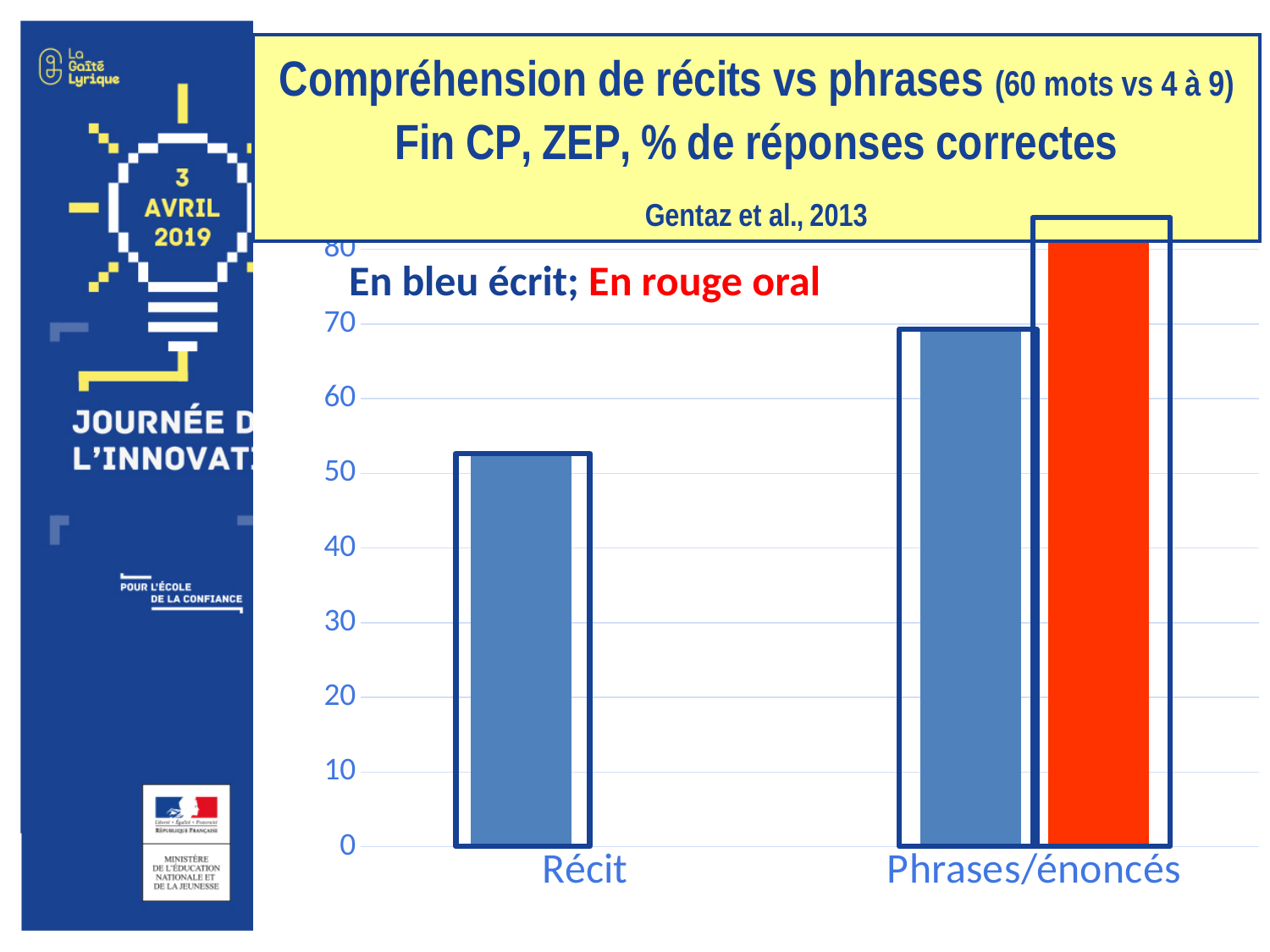
For Phrases/énoncés, which bar is taller, the blue (écrit) one or the red (oral) one? the red (oral) one Is the blue (écrit) bar for Phrases/énoncés greater or less than 60? greater According to the slide, what do the red bars represent? oral Is the blue (écrit) bar for Récit greater or less than 50? greater Is the blue (écrit) bar for Récit greater or less than 60? less Do the blue (écrit) values rise or fall from Récit to Phrases/énoncés? rise Which bar in the chart is the shortest? the blue (écrit) bar for Récit What kind of chart is shown on the slide? bar chart How many categories are shown on the x axis of the chart? 2 Which category has the higher blue (écrit) bar, Récit or Phrases/énoncés? Phrases/énoncés Which bar in the chart is the tallest? the red (oral) bar for Phrases/énoncés